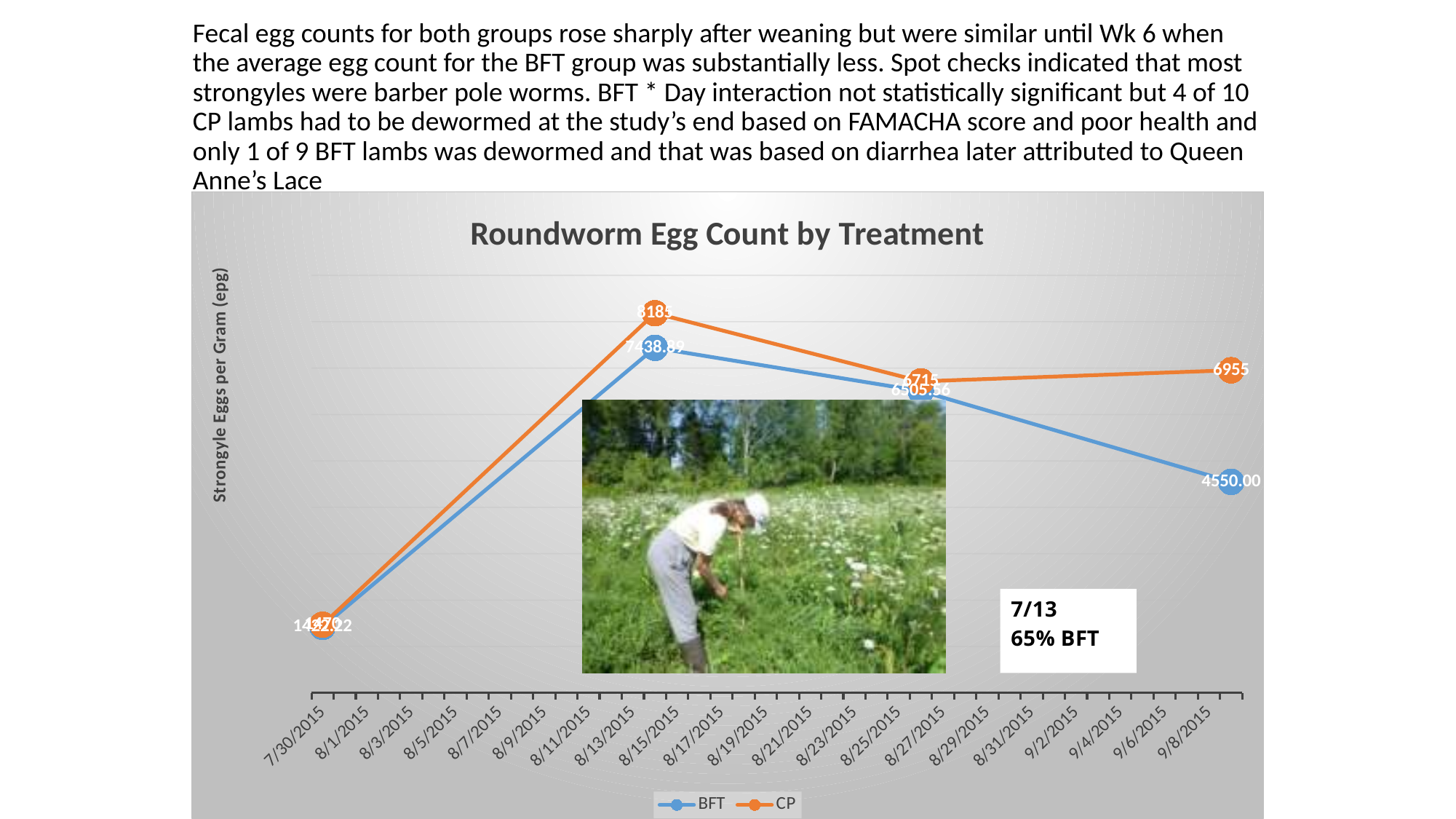
Does the BFT series rise or fall from its peak to 9/8/2015? fall How many series does the legend list? 2 On which date is the BFT series at its lowest value? 7/30/2015 What is the highest value plotted for the CP series? 8185 On 9/8/2015, which series has the higher value, BFT or CP? CP What is the BFT value on 9/8/2015? 4550.00 How many data points are plotted for the BFT series? 4 What is the title of the chart? Roundworm Egg Count by Treatment What is the CP value on 9/8/2015? 6955 What is the difference between the CP and BFT values on 9/8/2015? 2405 What type of chart is shown on the slide? line chart What is the highest value plotted for the BFT series? 7438.89